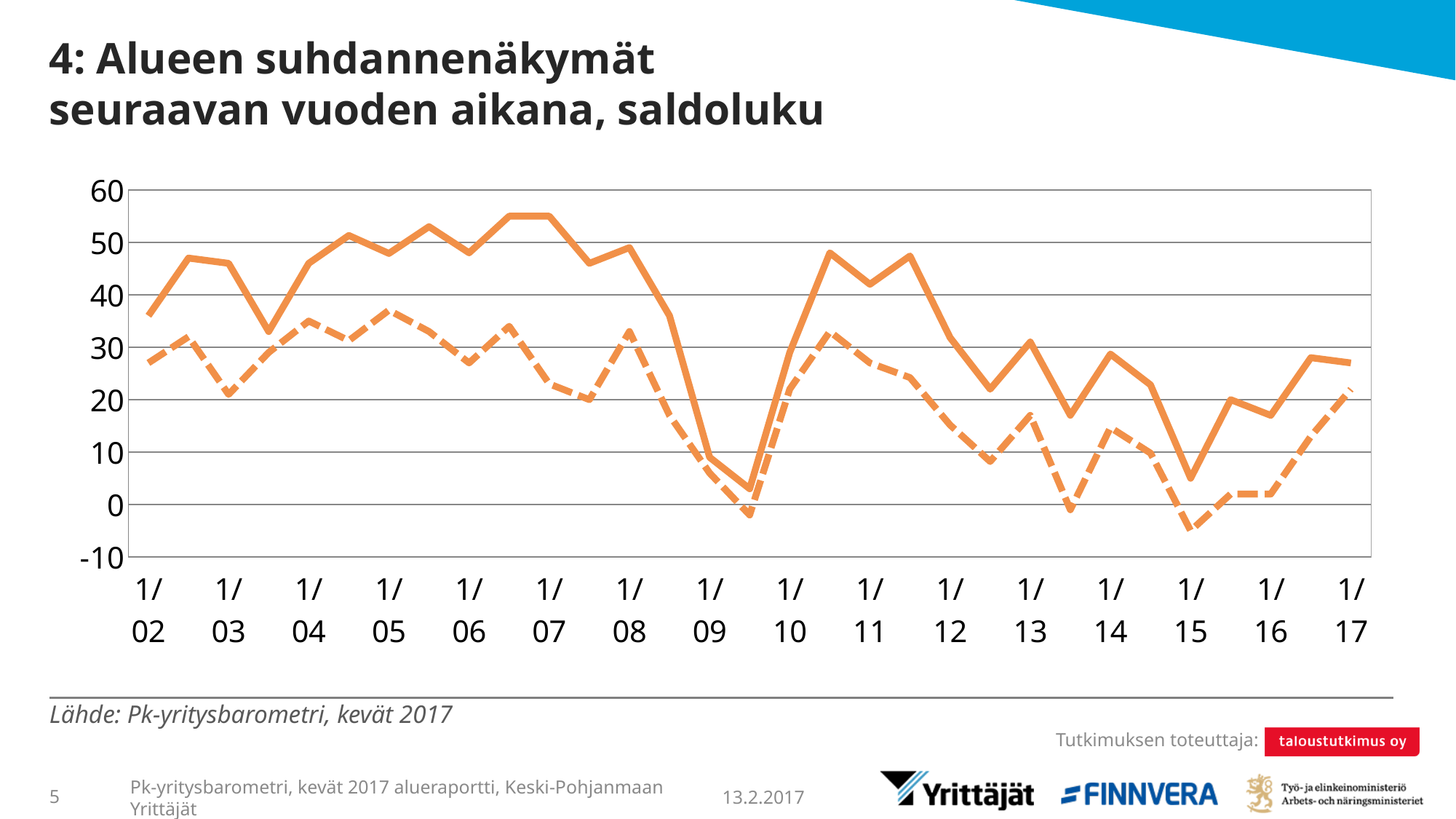
Is the value of the solid line at 1/09 greater or less than 20? less At 1/11, which line has the higher value, the solid line or the dashed line? the solid line Is the value of the solid line at 1/07 greater or less than 50? greater What is the title of the slide? 4: Alueen suhdannenäkymät seuraavan vuoden aikana, saldoluku What kind of chart is shown on the slide? line chart Is the value of the solid line at 1/15 greater or less than 10? less How many lines are plotted on the chart? 2 Around which x-axis label does the solid line reach its highest value? 1/07 Between 1/11 and 1/15, does the solid line rise or fall overall? fall How many labels are shown on the x axis of the chart? 16 Between 1/15 and 1/17, does the solid line rise or fall overall? rise